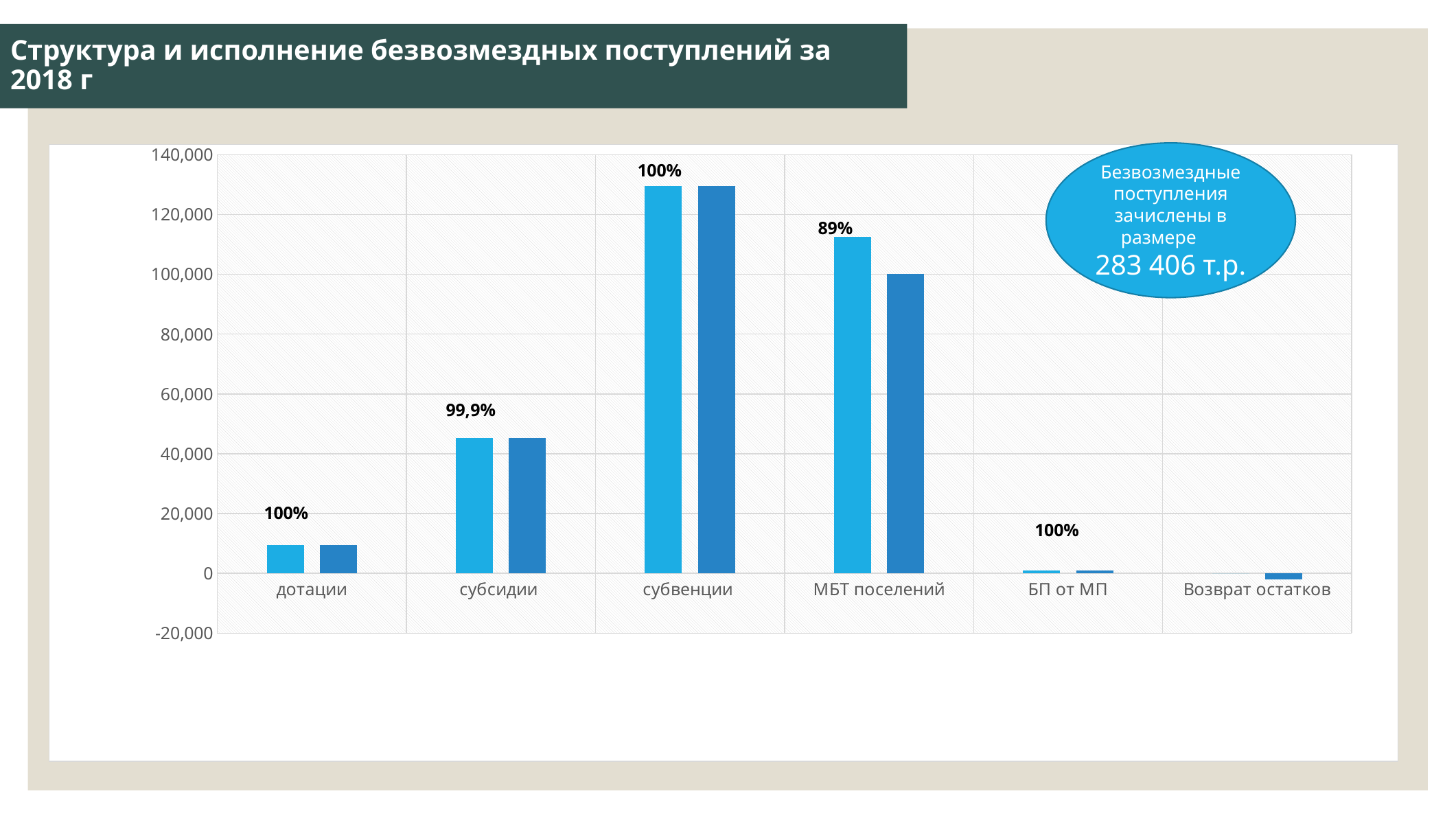
Is the value of the light blue bar for дотации greater or less than 20,000? less Which category has the lowest value in the chart? Возврат остатков What percentage label is shown above the bars for МБТ поселений? 89% Which category is the only one with a negative bar? Возврат остатков What total amount of безвозмездные поступления is stated in the oval callout on the chart? 283 406 т.р. What kind of chart is shown on the slide? bar chart Is the value of the light blue bar for субсидии greater or less than 60,000? less What percentage label is shown above the bars for субсидии? 99,9% Which category has the highest bars in the chart? субвенции Is the value of the light blue bar for субвенции greater or less than 120,000? greater Which has the larger light blue bar, МБТ поселений or субсидии? МБТ поселений How many categories are shown on the x axis of the chart? 6